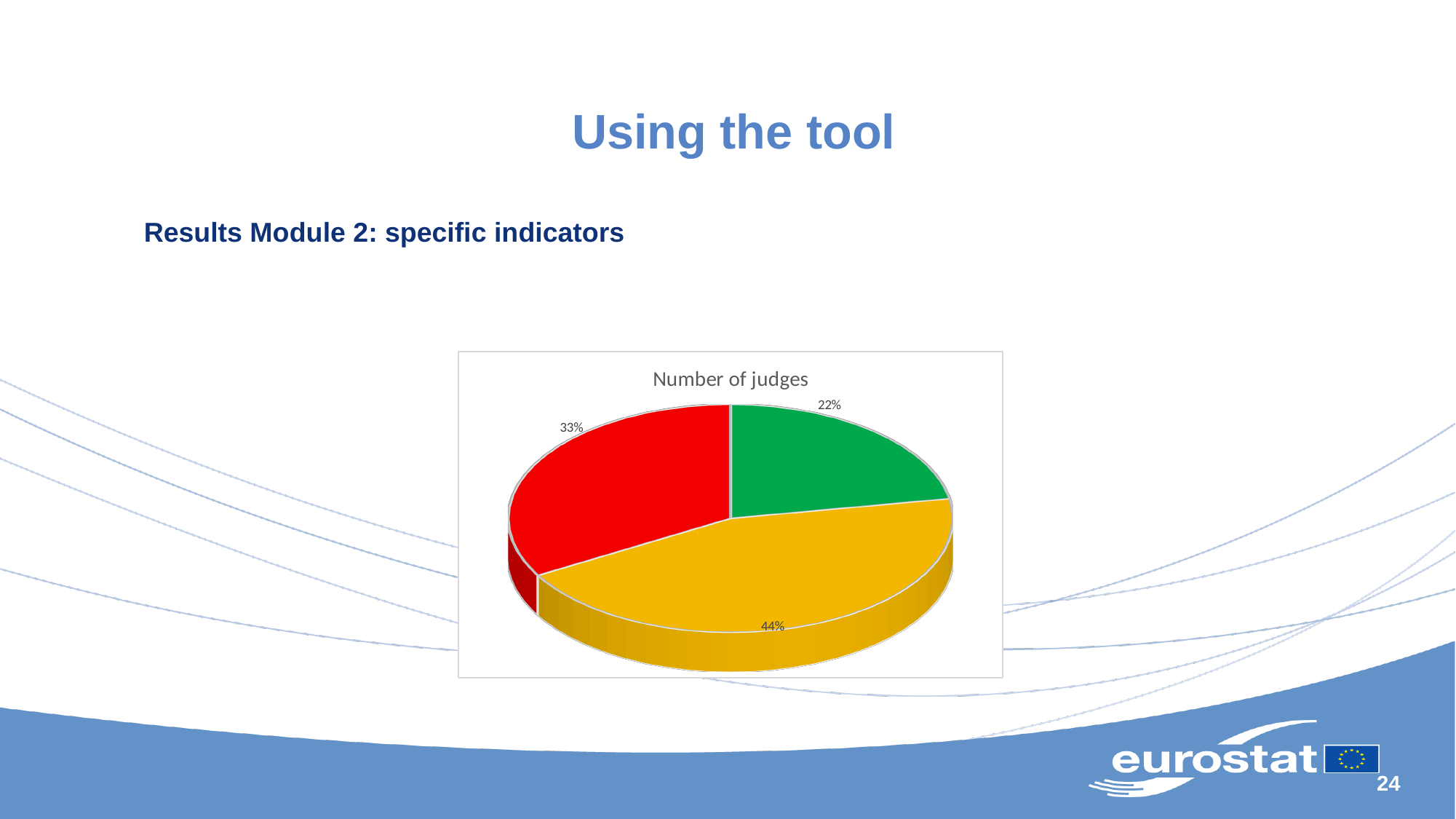
Which is larger, the red slice or the green slice? red Which colour slice is the largest in the pie chart? yellow What is the difference in percentage points between the red slice and the green slice? 11 Which colour slice is the smallest in the pie chart? green What is the difference in percentage points between the yellow slice and the green slice? 22 What percentage is shown for the yellow slice of the pie chart? 44% How many slices does the pie chart have? 3 What is the share of the largest slice in the pie chart? 44% What is the title of the chart? Number of judges What percentage is shown for the red slice of the pie chart? 33% What percentage is shown for the green slice of the pie chart? 22% What kind of chart is shown on the slide? pie chart